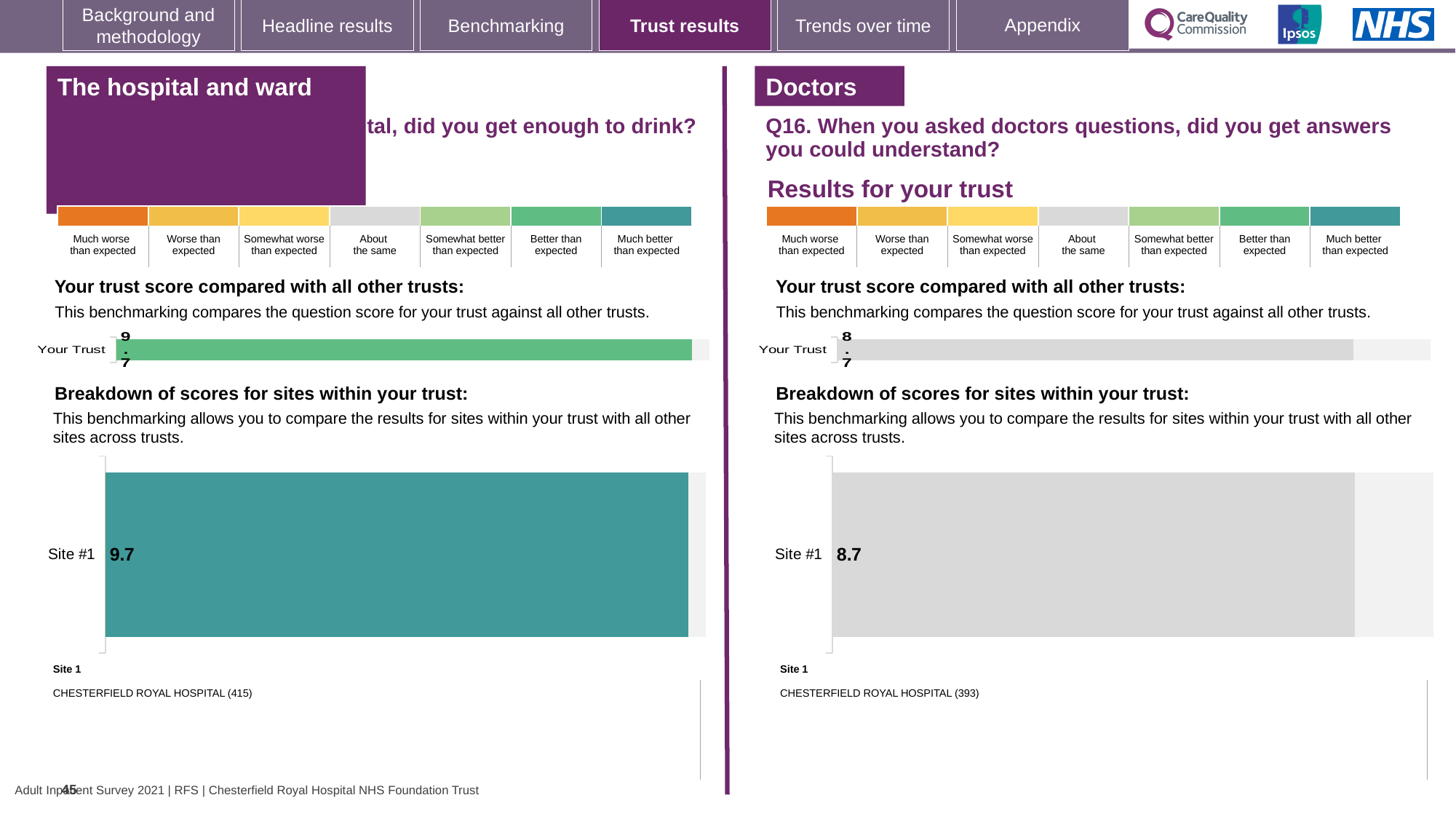
On the left-hand 'Breakdown of scores for sites within your trust' chart, what is the value labelled for Site #1? 9.7 According to the colour key, which benchmark category does the grey colour of the Site #1 bar on the right-hand (Doctors) breakdown chart represent? About the same What kind of chart is used to show the Site #1 score on the left-hand 'Breakdown of scores for sites within your trust' section? Bar chart What is the difference between the Site #1 score on the left-hand breakdown chart and the Site #1 score on the right-hand breakdown chart? 1.0 On the right-hand 'Breakdown of scores for sites within your trust' chart (Doctors, Q16), what is the value labelled for Site #1? 8.7 How many bars are shown on the left-hand 'Your trust score compared with all other trusts' chart? 1 Which site name is listed under the right-hand (Doctors) breakdown chart as Site 1? CHESTERFIELD ROYAL HOSPITAL (393) According to the colour key, which benchmark category does the teal colour of the Site #1 bar on the left-hand breakdown chart represent? Much better than expected On the left-hand 'Your trust score compared with all other trusts' chart, what is the value shown for Your Trust? 9.7 On the right-hand 'Your trust score compared with all other trusts' chart (Doctors, Q16), what is the value shown for Your Trust? 8.7 Which is larger: the Your Trust score on the left-hand chart or the Your Trust score on the right-hand (Doctors) chart? The left-hand chart (9.7) How many sites are plotted on the right-hand 'Breakdown of scores for sites within your trust' chart? 1